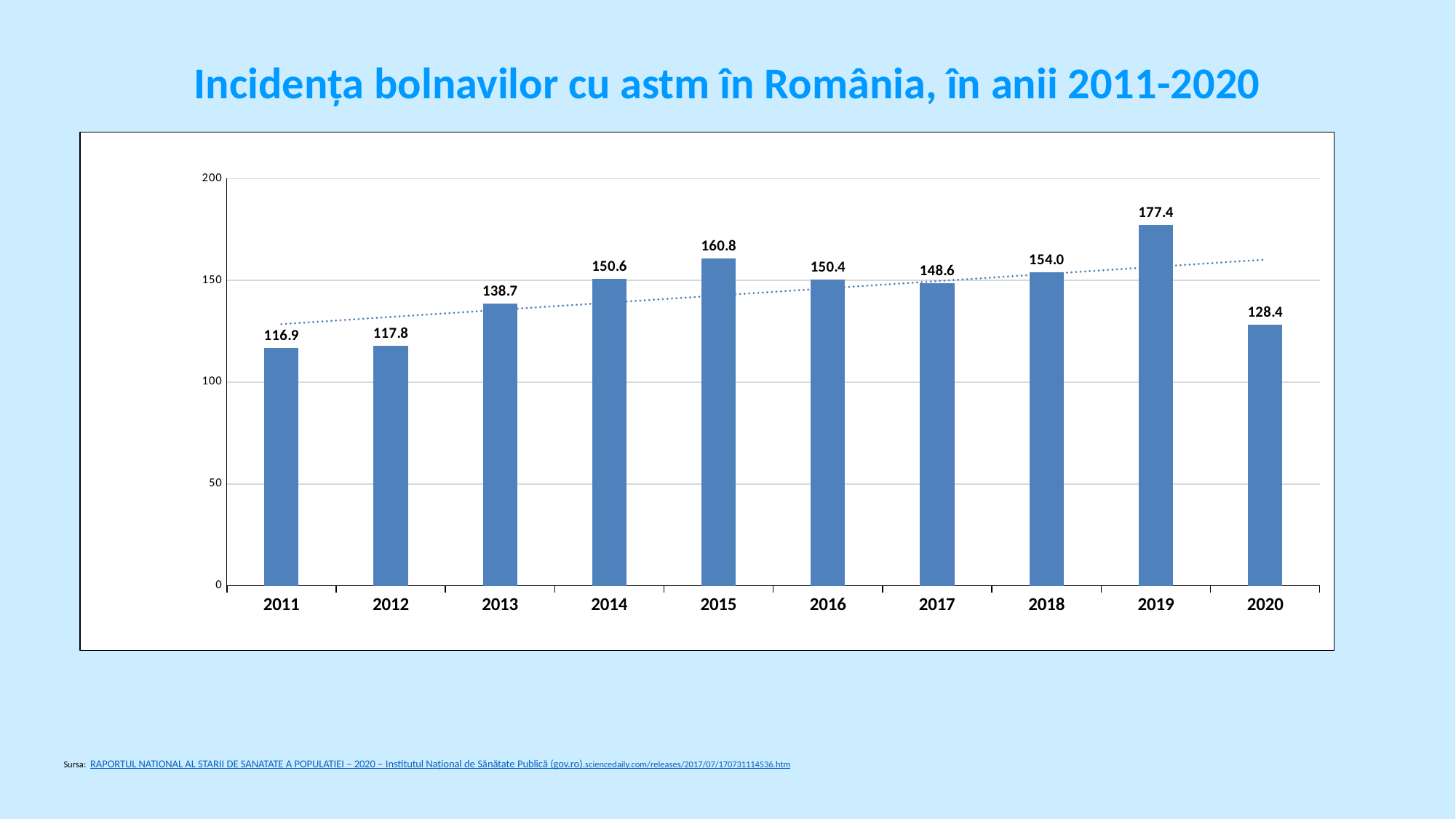
What kind of chart is shown on the slide? bar chart What is the title of the slide? Incidența bolnavilor cu astm în România, în anii 2011-2020 What is the value for 2020? 128.4 Which year has the highest value? 2019 What is the difference between the values for 2019 and 2020? 49.0 What is the difference between the values for 2013 and 2012? 20.9 What is the value for 2015? 160.8 Which is larger, the value for 2014 or the value for 2016? 2014 How many years are shown on the x axis? 10 Which year has the lowest value? 2011 What is the value for 2011? 116.9 Is the value for 2018 greater or less than 150? greater